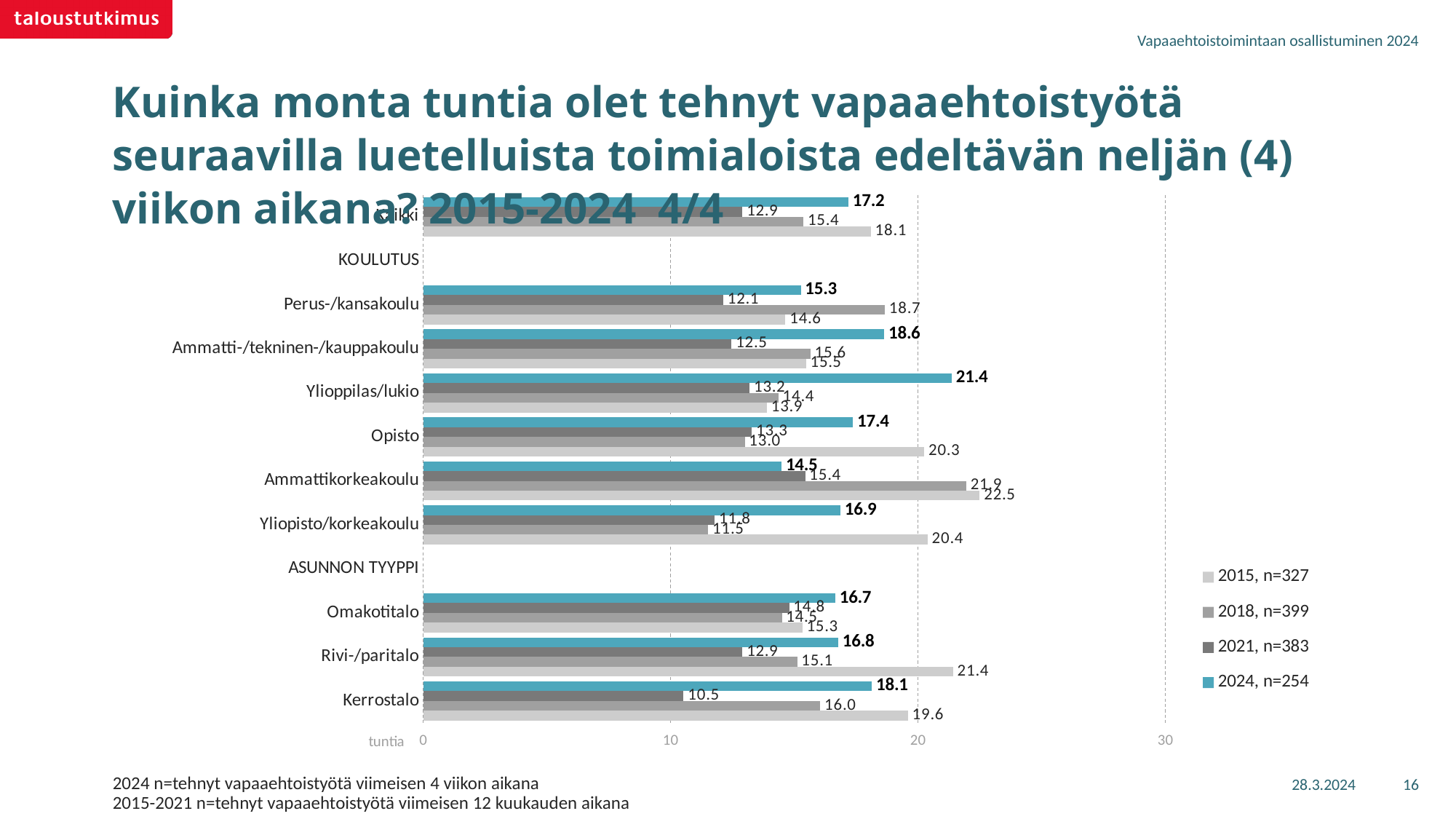
Which category has the lowest 2024 value? Ammattikorkeakoulu What kind of chart is shown on the slide? bar chart For Rivi-/paritalo, which is larger: the 2015 value or the 2024 value? 2015 Which category has the highest 2024 value? Ylioppilas/lukio What is the 2024 value for Ylioppilas/lukio? 21.4 What is the 2015 value for Kerrostalo? 19.6 Is the 2015 value for Ammattikorkeakoulu greater or less than 20? greater According to the legend, what is the sample size (n) for 2024? 254 What is the 2021 value for Kerrostalo? 10.5 How many series does the legend list? 4 What is the difference between the 2024 and 2021 values for Kerrostalo? 7.6 What is the 2024 value for Omakotitalo? 16.7